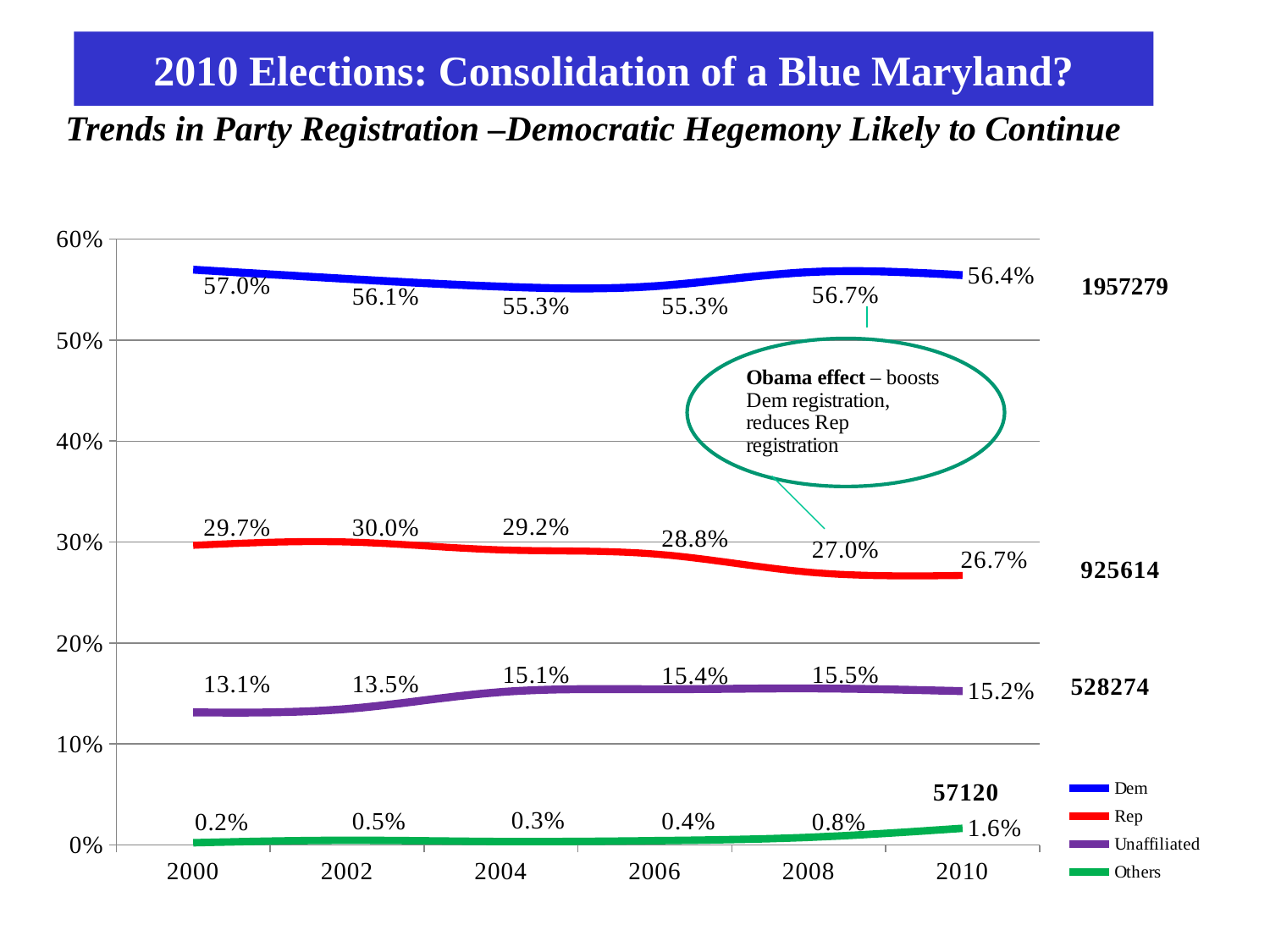
What was the Unaffiliated share in 2008? 15.5% What kind of chart is this? Line chart Which was larger in 2006, the Rep share or the Unaffiliated share? Rep What was the Others share in 2010? 1.6% Does the Rep share rise or fall from 2002 to 2010? Fall How many series does the legend list? 4 In which year was the Rep share highest? 2002 What is the difference between the Dem share in 2000 and in 2010? 0.6% How many years are plotted on the x axis? 6 In which year was the Others share lowest? 2000 What was the Rep registration share in 2010? 26.7% What was the Dem registration share in 2000? 57.0%